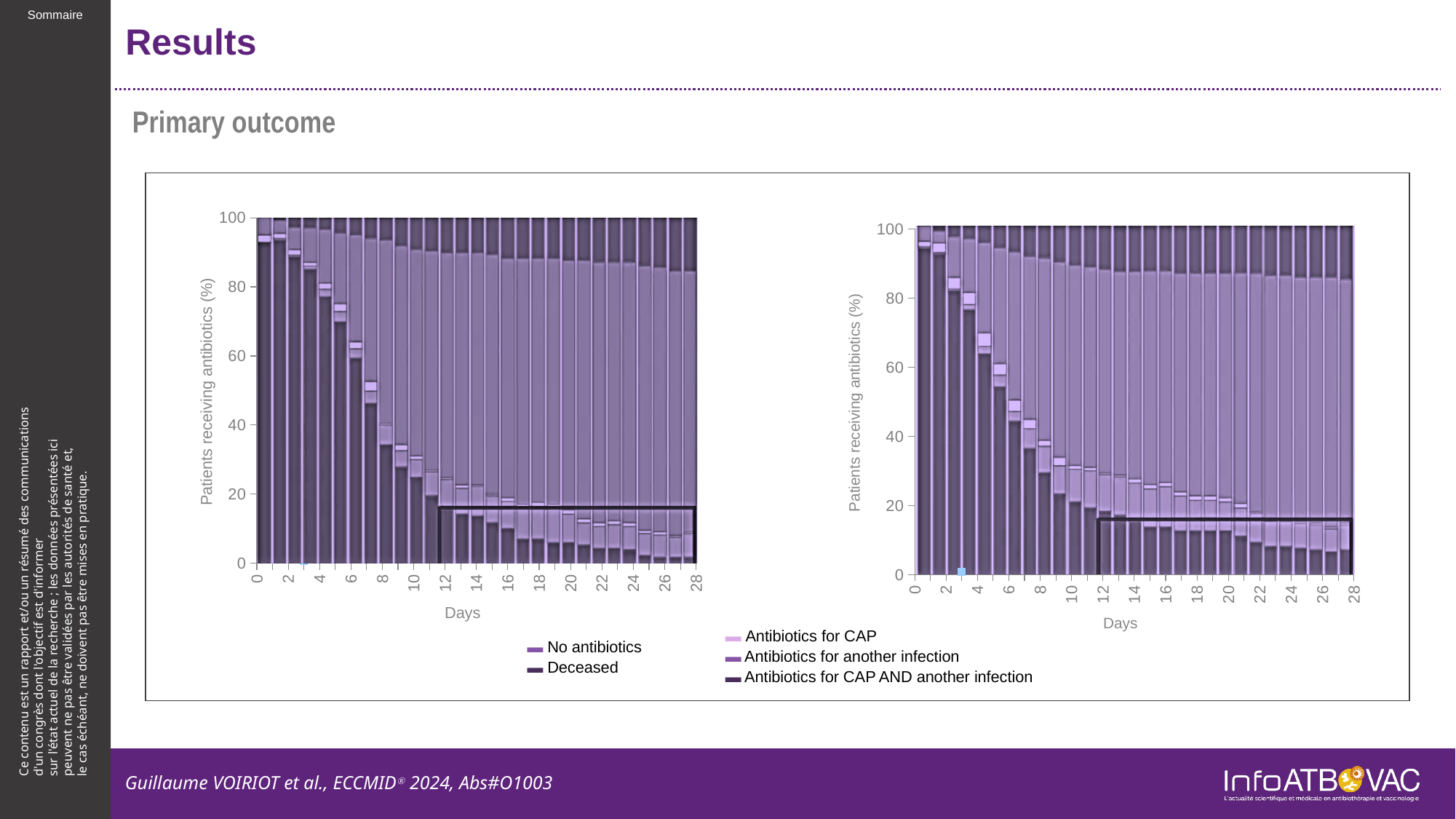
On the right chart, what is the highest value shown on the y axis? 100 What is the y-axis title of the left chart? Patients receiving antibiotics (%) On the right chart, does the bottom (lightest) segment rise or fall from day 0 to day 28? fall On the left chart, is the bottom (lightest) segment at day 0 greater or less than 80? greater How many series does the legend list? 5 What kind of chart is the right chart? stacked bar chart On the left chart, what is the last day shown on the x axis? 28 What kind of chart is the left chart? stacked bar chart On the left chart, does the bottom (lightest) segment rise or fall from day 0 to day 28? fall On the left chart, is the bottom (lightest) segment at day 28 greater or less than 20? less What is the x-axis title of the right chart? Days On the right chart, is the bottom (lightest) segment at day 0 greater or less than 80? greater